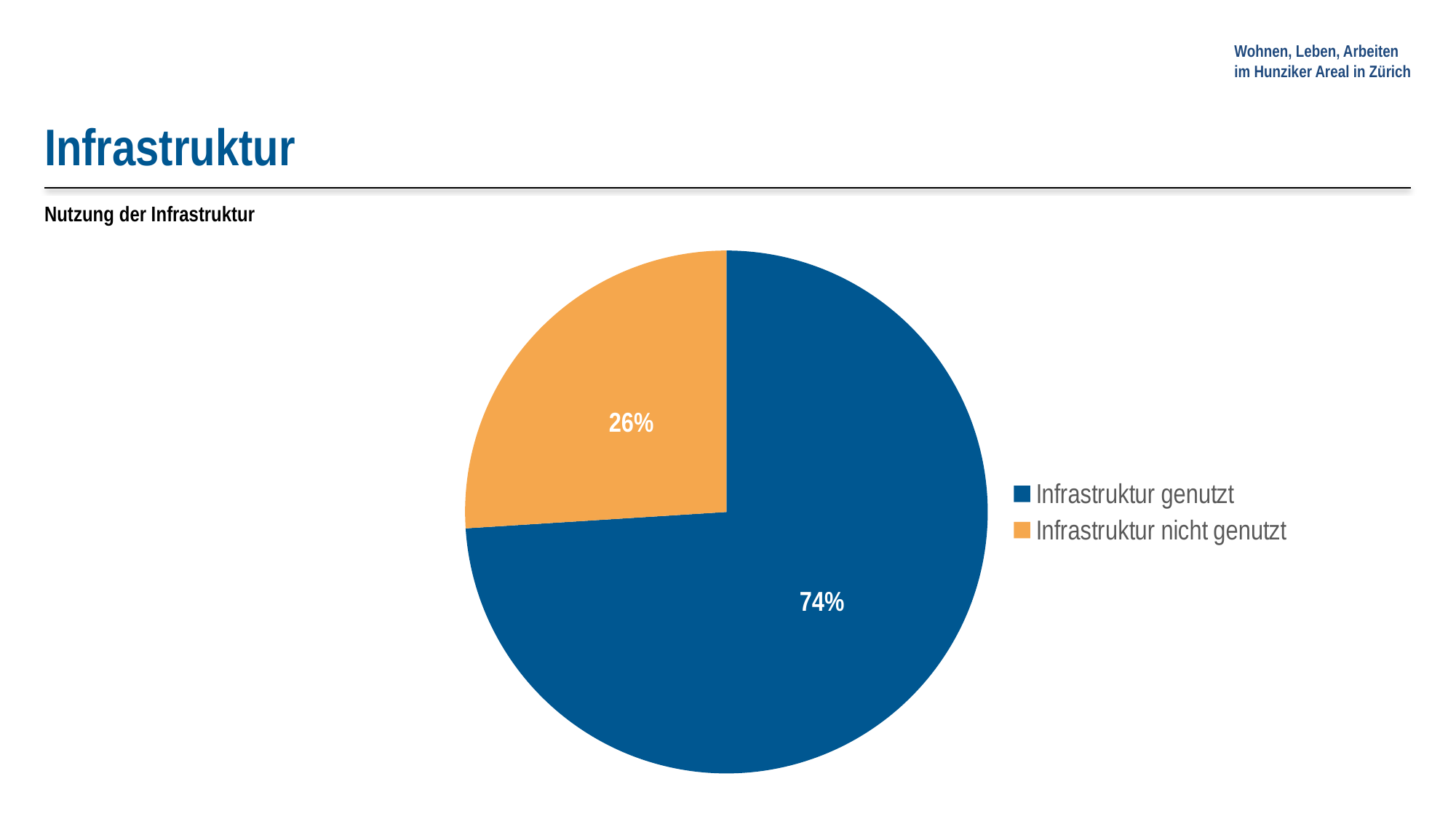
What share of the pie is labelled "Infrastruktur nicht genutzt"? 26% What is the difference in percentage points between the "Infrastruktur genutzt" and "Infrastruktur nicht genutzt" slices? 48 percentage points What kind of chart is shown on the slide? pie chart What colour is the "Infrastruktur nicht genutzt" slice? orange Which is larger: the "Infrastruktur genutzt" slice or the "Infrastruktur nicht genutzt" slice? Infrastruktur genutzt Which slice of the pie is the smallest? Infrastruktur nicht genutzt How many entries does the legend list? 2 What is the subtitle shown above the pie chart? Nutzung der Infrastruktur Which slice of the pie is the largest? Infrastruktur genutzt What share of the pie is labelled "Infrastruktur genutzt"? 74% How many slices does the pie chart have? 2 Is the share for "Infrastruktur genutzt" greater or less than 50%? greater